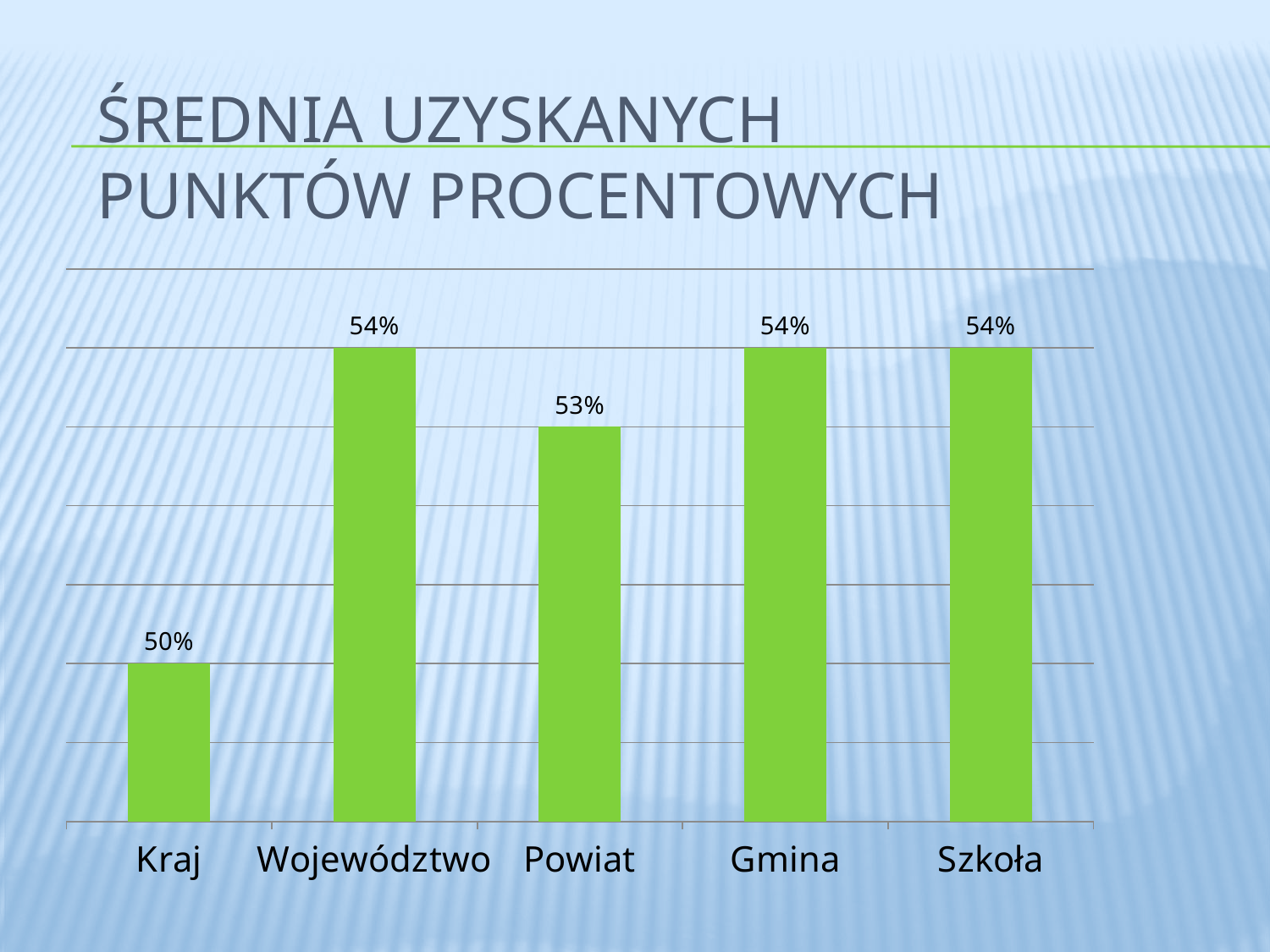
What is the difference between the values for Gmina and Powiat? 1% What is the value for Województwo? 54% How many categories are shown on the x axis? 5 Which is larger, the value for Powiat or the value for Kraj? Powiat What is the difference between the values for Województwo and Kraj? 4% What is the title of the slide containing the chart? Średnia uzyskanych punktów procentowych What kind of chart is shown on the slide? Bar chart What is the value for Powiat? 53% Which category has the lowest value? Kraj What is the value for Szkoła? 54% What is the value for Gmina? 54% What is the value for Kraj? 50%